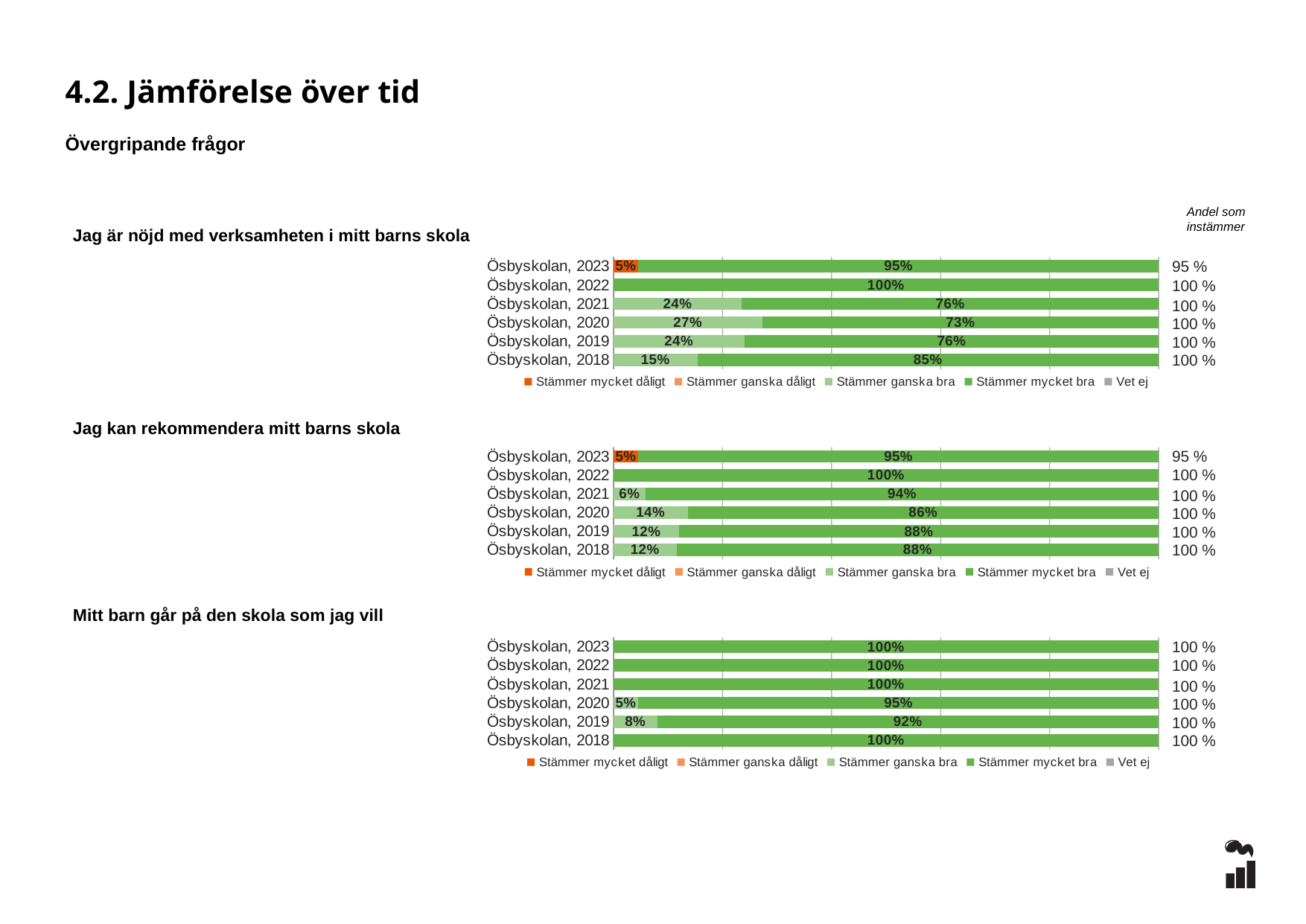
In the chart 'Jag är nöjd med verksamheten i mitt barns skola', which year has the lowest 'Stämmer mycket bra' value? Ösbyskolan, 2020 In the chart 'Mitt barn går på den skola som jag vill', what is the 'Stämmer ganska bra' value for Ösbyskolan, 2019? 8% What kind of chart is 'Mitt barn går på den skola som jag vill'? Stacked bar chart In the chart 'Jag kan rekommendera mitt barns skola', what is the 'Stämmer mycket bra' value for Ösbyskolan, 2021? 94% In the chart 'Mitt barn går på den skola som jag vill', how many years (bars) are shown? 6 In the chart 'Jag är nöjd med verksamheten i mitt barns skola', what is the 'Stämmer ganska bra' value for Ösbyskolan, 2018? 15% In the chart 'Jag kan rekommendera mitt barns skola', which year has the highest 'Stämmer ganska bra' value? Ösbyskolan, 2020 In the chart 'Mitt barn går på den skola som jag vill', what is the 'Stämmer mycket bra' value for Ösbyskolan, 2020? 95% In the chart 'Jag är nöjd med verksamheten i mitt barns skola', what is the difference between the 'Stämmer ganska bra' values for Ösbyskolan, 2020 and Ösbyskolan, 2018? 12% In the chart 'Jag kan rekommendera mitt barns skola', how many series does the legend list? 5 In the chart 'Jag är nöjd med verksamheten i mitt barns skola', what is the 'Stämmer mycket bra' value for Ösbyskolan, 2020? 73% In the chart 'Jag kan rekommendera mitt barns skola', is the 'Stämmer mycket bra' value larger for Ösbyskolan, 2021 or Ösbyskolan, 2020? Ösbyskolan, 2021